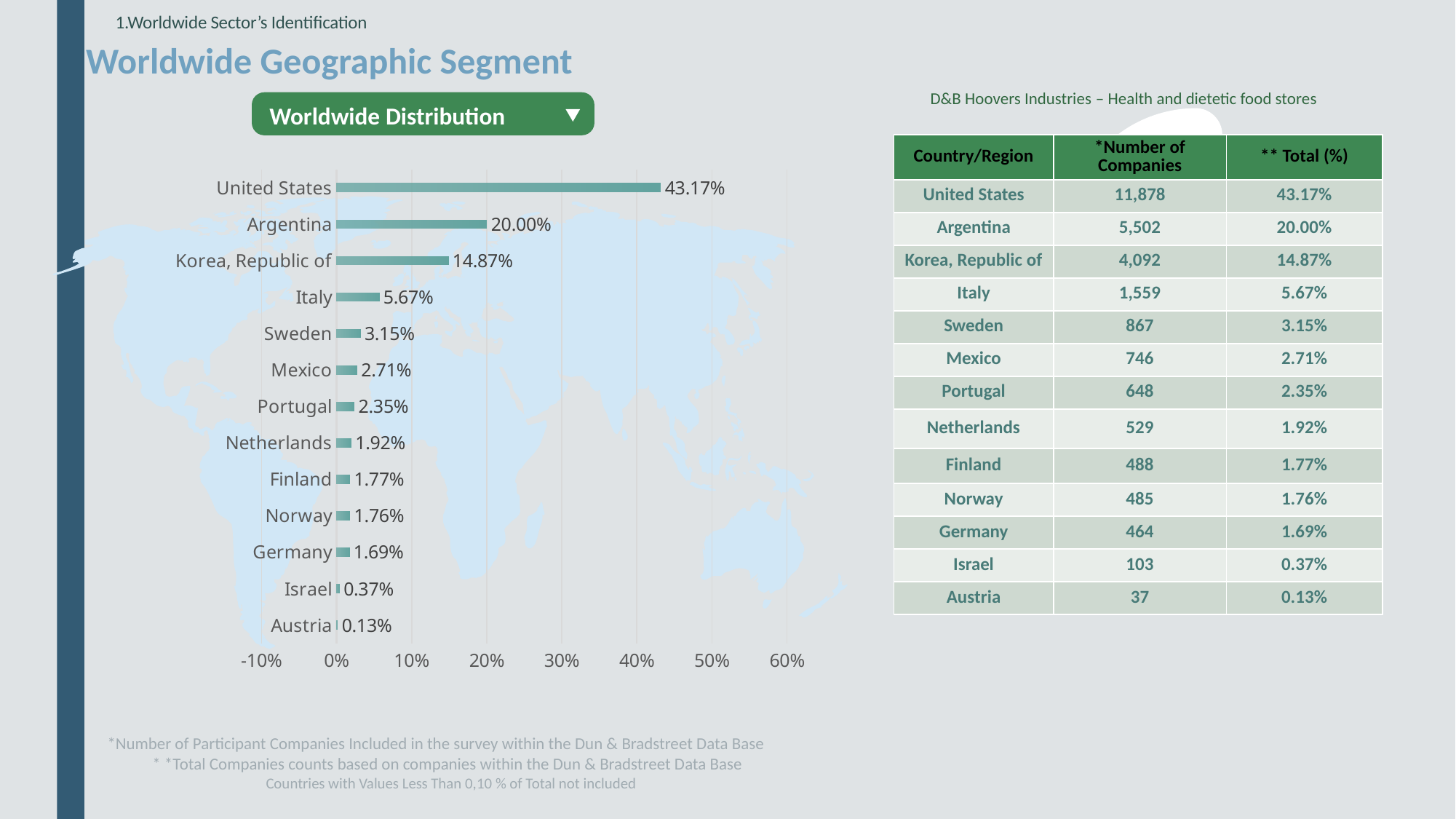
What is the difference between the values for the United States and Argentina in the Worldwide Distribution chart? 23.17% What is the value for the United States in the Worldwide Distribution chart? 43.17% Is the value for the United States in the Worldwide Distribution chart greater or less than 40%? greater What kind of chart is the Worldwide Distribution chart? Bar chart What is the value for Korea, Republic of in the Worldwide Distribution chart? 14.87% How many countries are shown in the Worldwide Distribution chart? 13 What is the value for Portugal in the Worldwide Distribution chart? 2.35% Which country has the highest value in the Worldwide Distribution chart? United States Which country has the lowest value in the Worldwide Distribution chart? Austria What is the difference between the values for Italy and Sweden in the Worldwide Distribution chart? 2.52% What is the title shown above the bar chart? Worldwide Distribution Which has a larger value in the Worldwide Distribution chart, Argentina or Korea, Republic of? Argentina